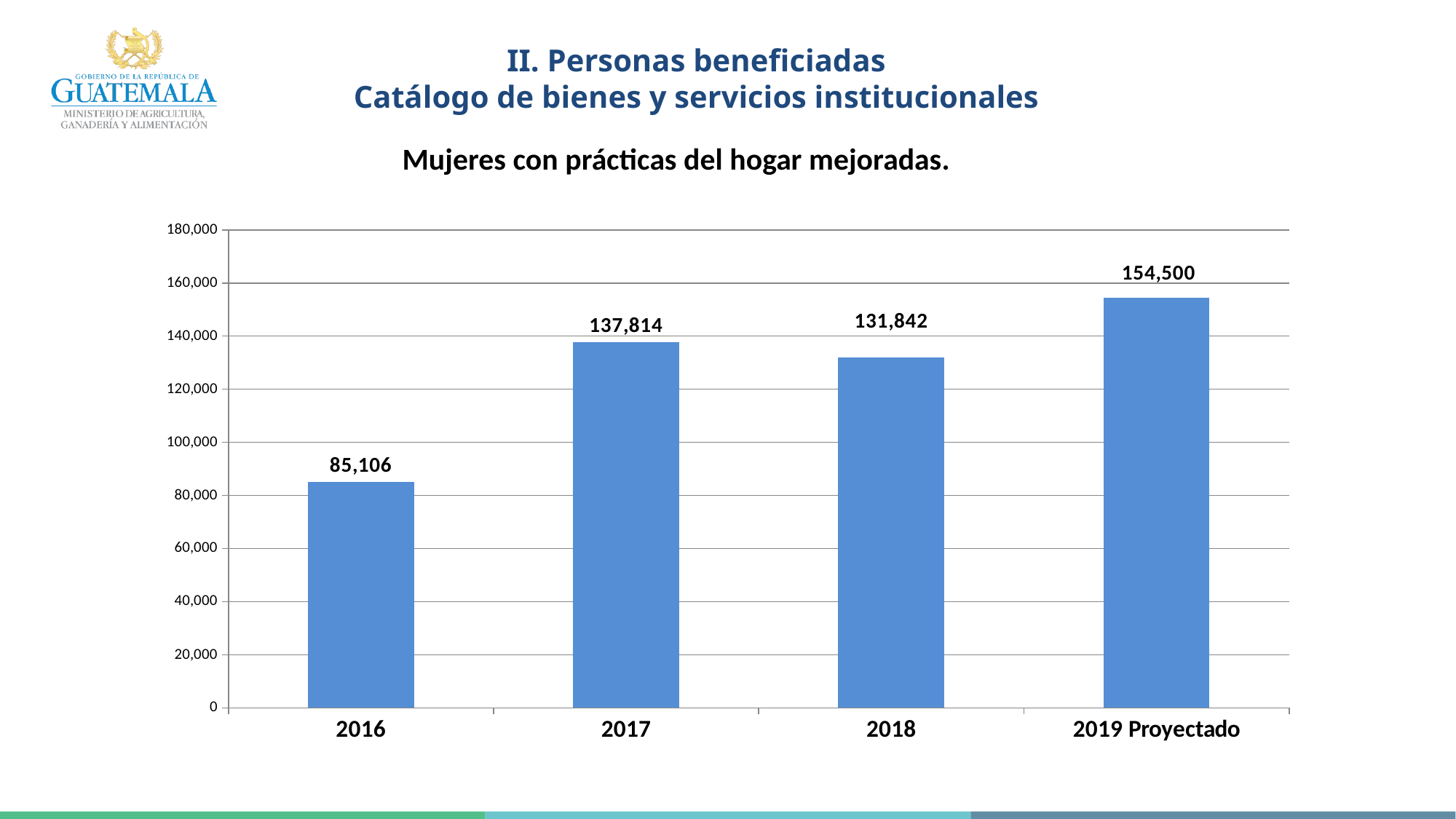
How many categories are shown on the x axis? 4 Which is larger, the value for 2017 or the value for 2018? 2017 What is the value for 2017? 137,814 Which category has the lowest value? 2016 What is the value for 2018? 131,842 Which category has the highest value? 2019 Proyectado What kind of chart is shown on the slide? Bar chart What is the value for 2016? 85,106 What is the title of the chart? Mujeres con prácticas del hogar mejoradas. What is the difference between the values for 2019 Proyectado and 2016? 69,394 What is the difference between the values for 2017 and 2018? 5,972 What is the value for 2019 Proyectado? 154,500